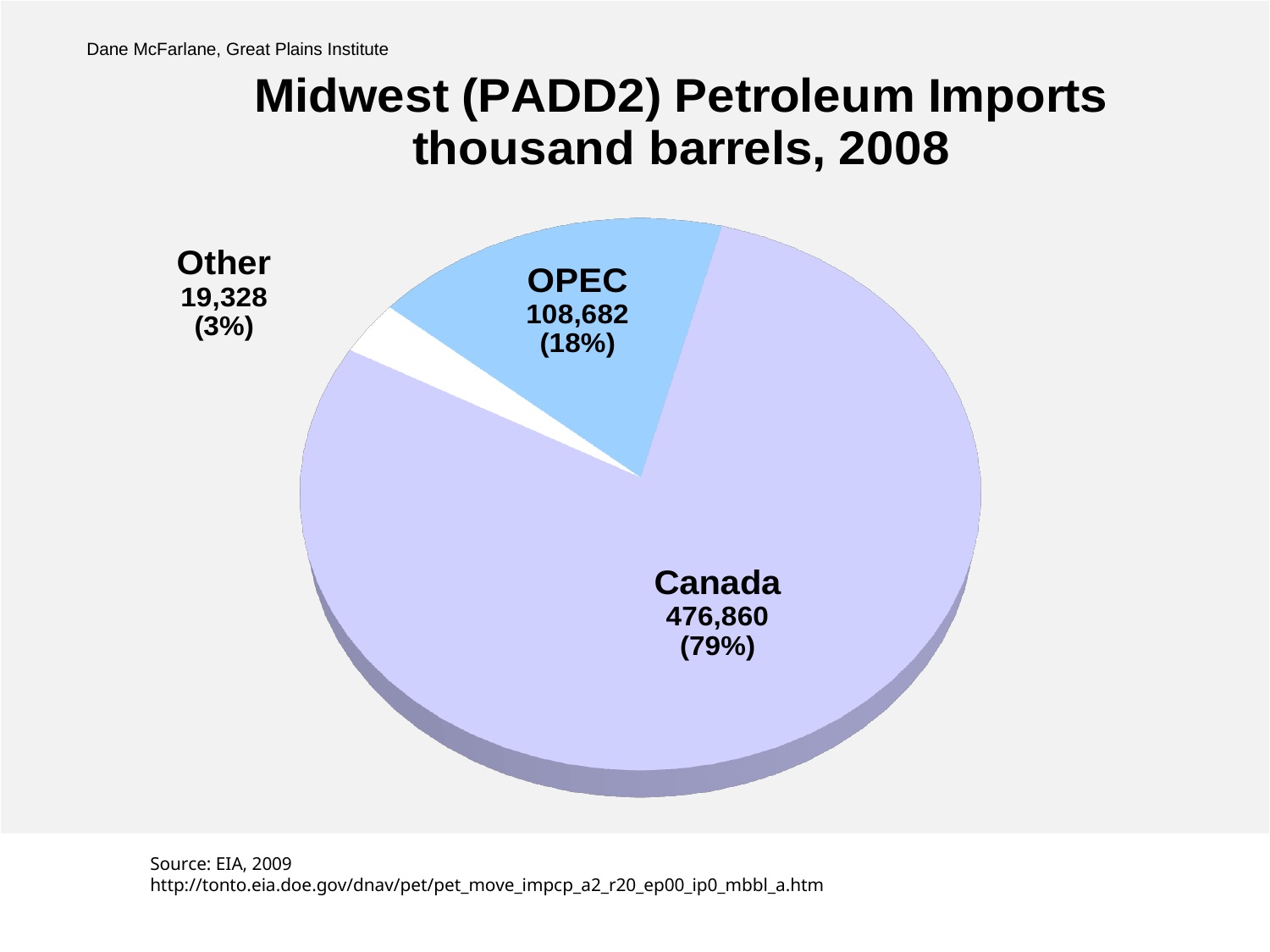
What is the value for OPEC? 108,682 How many slices does the pie chart have? 3 What is the title of the chart? Midwest (PADD2) Petroleum Imports thousand barrels, 2008 What is the difference between the values for Canada and OPEC? 368,178 What share of the pie does OPEC represent? 18% What kind of chart is shown on the slide? Pie chart Which category has the largest slice? Canada What share of the pie does Canada represent? 79% What is the value for Canada? 476,860 What is the value for Other? 19,328 Which is larger, the value for OPEC or the value for Other? OPEC Which category has the smallest slice? Other